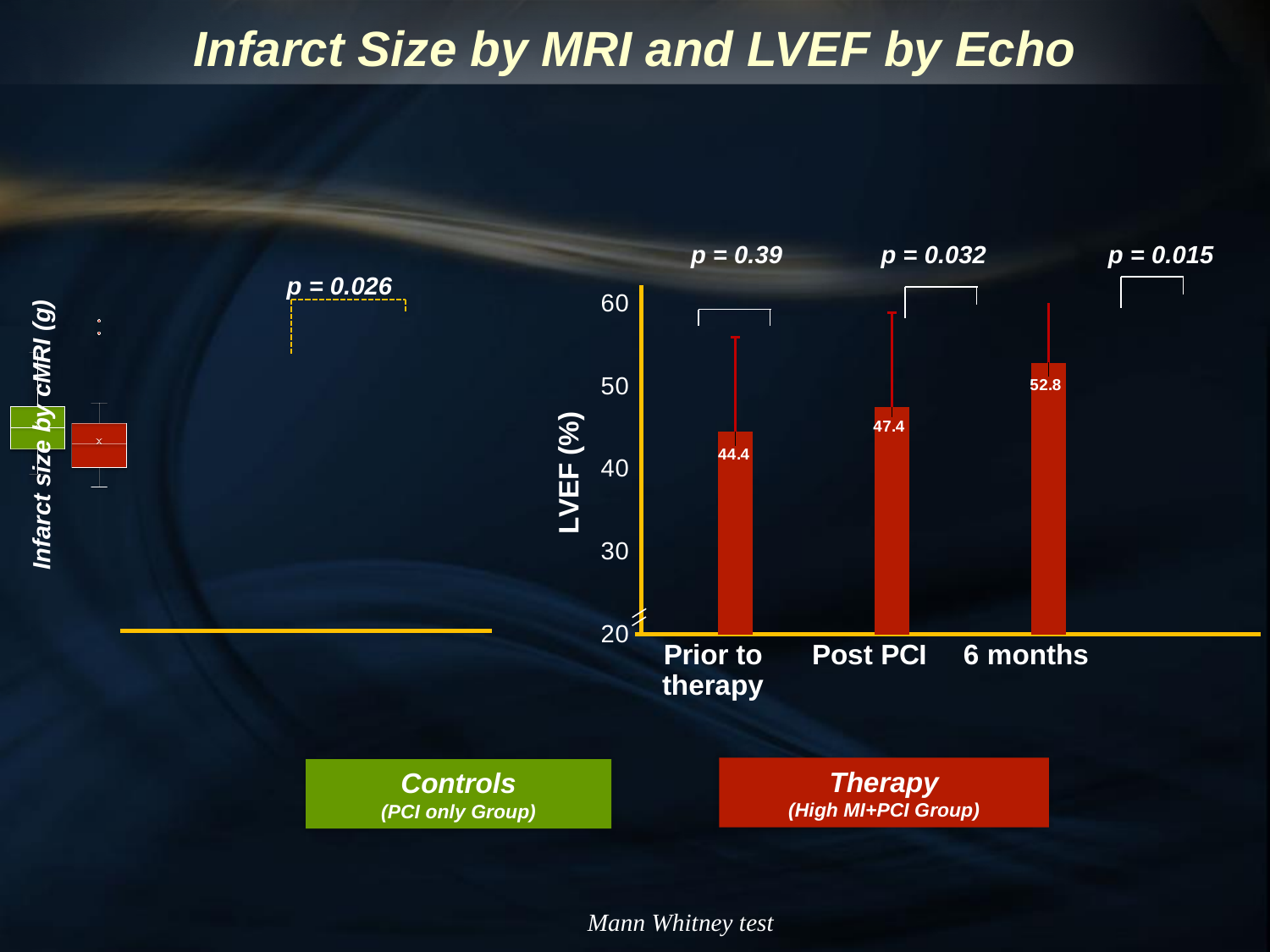
In the LVEF (%) bar chart, what is the difference between the 6 months value and the Prior to therapy value? 8.4 In the LVEF (%) bar chart, what is the difference between the Post PCI value and the Prior to therapy value? 3.0 In the LVEF (%) bar chart, what is the value for Prior to therapy? 44.4 In the LVEF (%) bar chart, which is larger, the Post PCI value or the 6 months value? 6 months In the LVEF (%) bar chart, do the values rise or fall from Prior to therapy to 6 months? rise In the LVEF (%) bar chart, how many time points are plotted? 3 In the LVEF (%) bar chart, what is the value for Post PCI? 47.4 In the LVEF (%) bar chart, what is the value at 6 months? 52.8 In the LVEF (%) bar chart, which time point has the lowest LVEF? Prior to therapy In the LVEF (%) bar chart, which time point has the highest LVEF? 6 months In the LVEF (%) bar chart, is the value at 6 months greater or less than 50? greater What kind of chart is the LVEF (%) chart on the right? bar chart